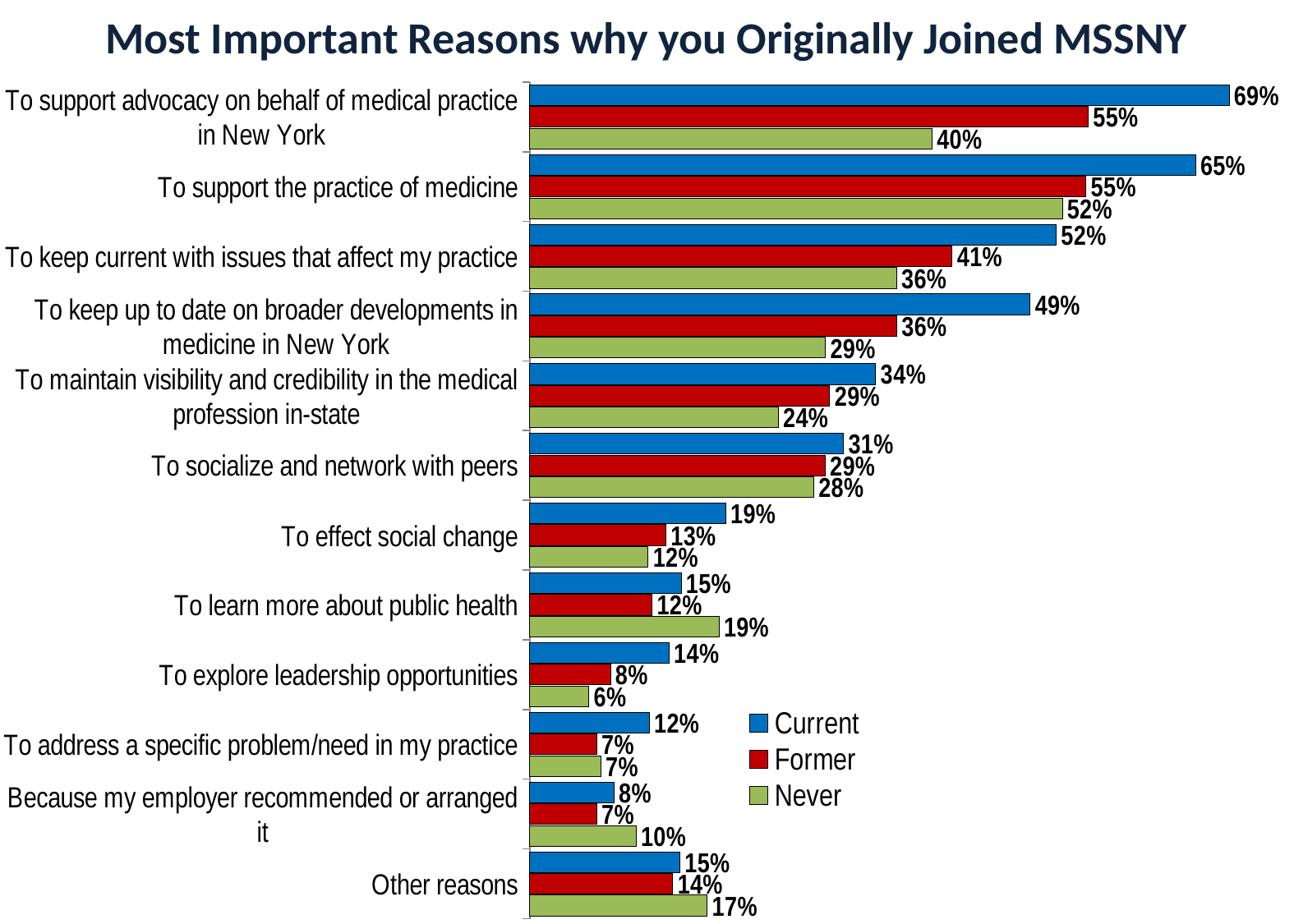
What is the difference between the Former and Never values for "To keep up to date on broader developments in medicine in New York"? 7% For "To learn more about public health", which is larger: the Current value or the Never value? Never What is the Former value for "To keep current with issues that affect my practice"? 41% What percentage of Current members cited "To support advocacy on behalf of medical practice in New York" as a reason for joining? 69% Which reason has the highest value for the Current series? To support advocacy on behalf of medical practice in New York How many reasons (categories) are shown on the chart? 12 What is the difference between the Current and Never values for "To support advocacy on behalf of medical practice in New York"? 29% What is the Never value for "To support the practice of medicine"? 52% How many series does the legend list? 3 Which reason has the lowest value for the Never series? To explore leadership opportunities What type of chart is shown on the slide? Bar chart Which colour represents the Former series in the legend? Red